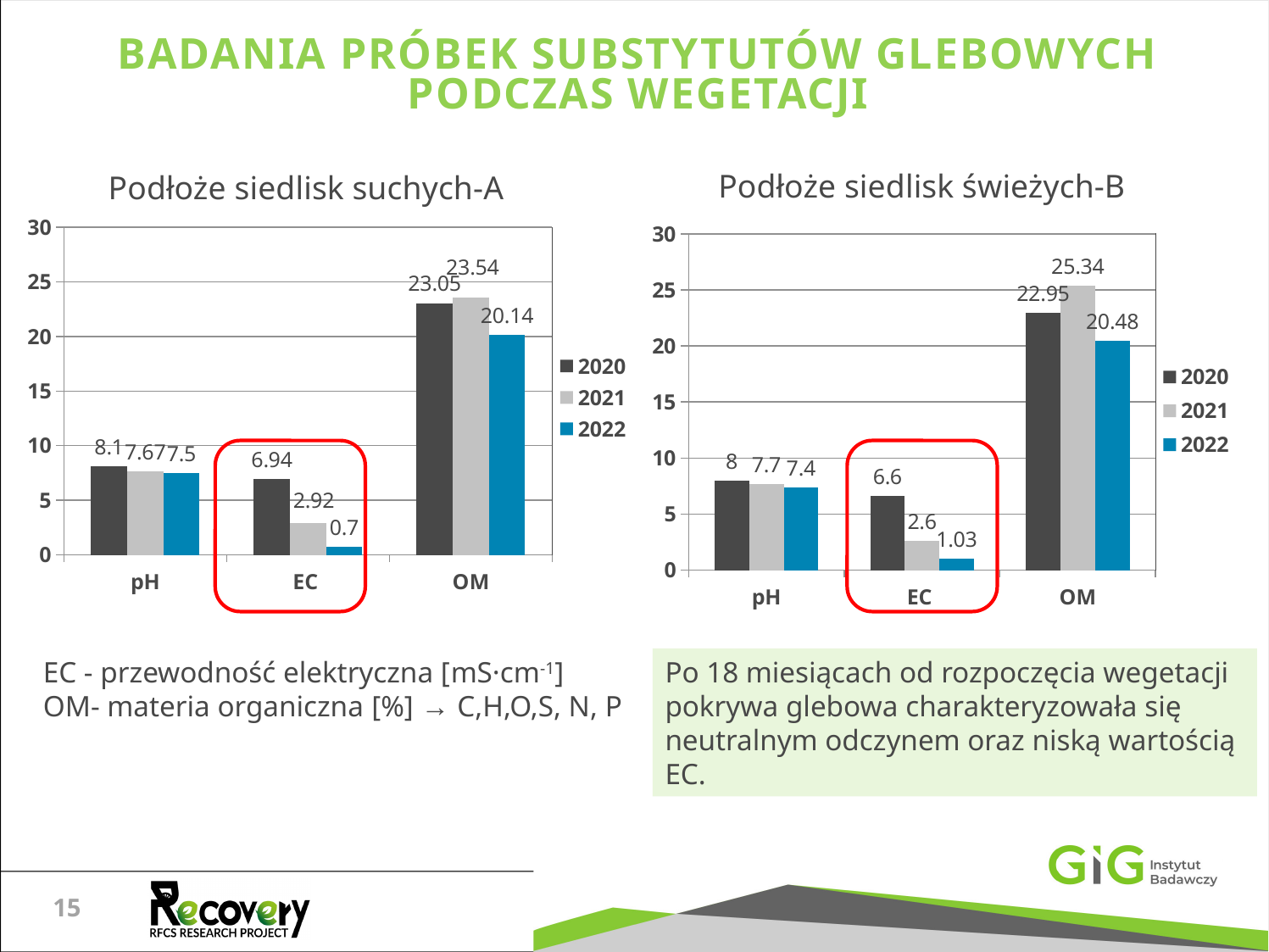
In the chart 'Podłoże siedlisk suchych-A', which year has the highest OM value? 2021 In the chart 'Podłoże siedlisk świeżych-B', which is larger: the pH value for 2020 or the EC value for 2020? pH value for 2020 In the chart 'Podłoże siedlisk suchych-A', what is the EC value for 2020? 6.94 In the chart 'Podłoże siedlisk suchych-A', what is the pH value for 2022? 7.5 How many series does the legend list in the chart 'Podłoże siedlisk suchych-A'? 3 In the chart 'Podłoże siedlisk świeżych-B', what is the OM value for 2021? 25.34 What kind of chart is 'Podłoże siedlisk suchych-A'? Bar chart In the chart 'Podłoże siedlisk suchych-A', what is the difference between the EC values for 2020 and 2022? 6.24 In the chart 'Podłoże siedlisk świeżych-B', what is the EC value for 2022? 1.03 In the chart 'Podłoże siedlisk świeżych-B', what is the difference between the OM values for 2021 and 2022? 4.86 How many categories are shown on the x axis of the chart 'Podłoże siedlisk świeżych-B'? 3 In the chart 'Podłoże siedlisk świeżych-B', which year has the lowest EC value? 2022